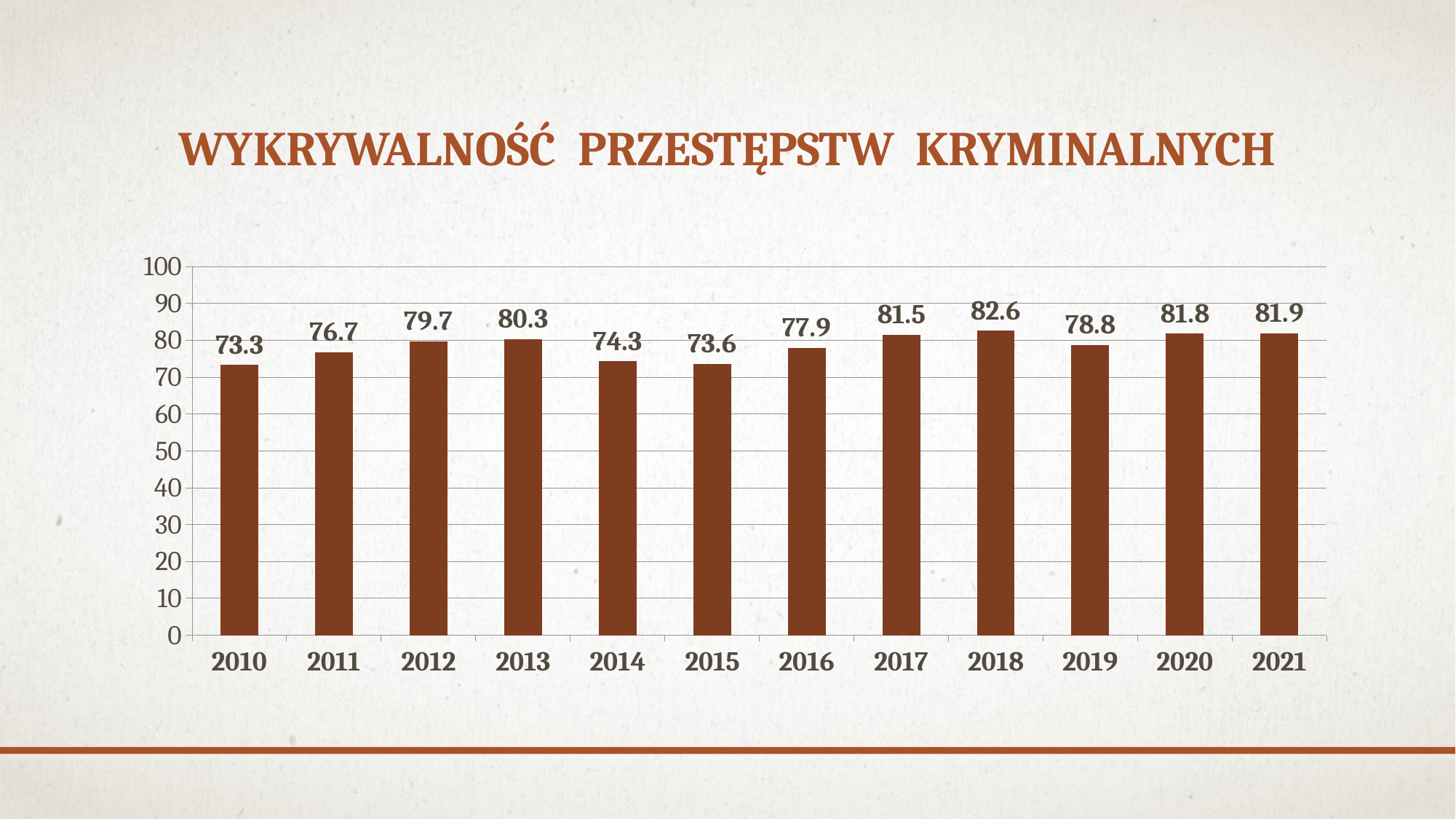
What is the title of the chart? WYKRYWALNOŚĆ PRZESTĘPSTW KRYMINALNYCH What is the difference between the values for 2021 and 2020? 0.1 Do the values rise or fall from 2014 to 2018? rise What kind of chart is shown on the slide? bar chart What is the difference between the values for 2018 and 2010? 9.3 Which is larger, the value for 2014 or the value for 2016? 2016 Which year has the highest value? 2018 Which year has the lowest value? 2010 What is the value for 2019? 78.8 How many years are shown on the x axis? 12 Is the value for 2015 greater or less than 80? less What is the value for 2013? 80.3